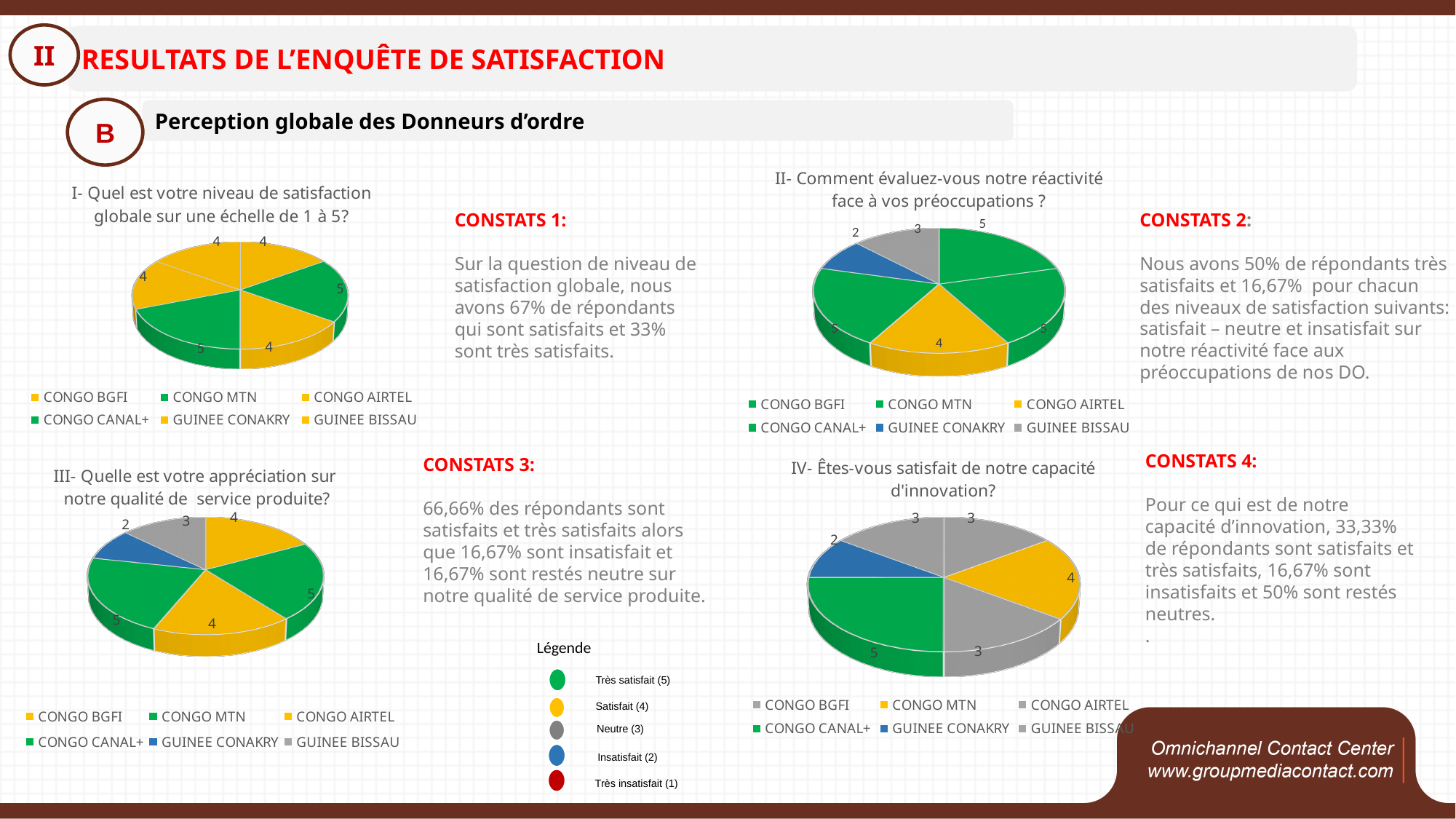
According to the 'Légende' box, which rating value does the green colour represent? Très satisfait (5) In the chart for question IV (capacité d'innovation), which is larger: the rating for CONGO MTN or the rating for GUINEE CONAKRY? CONGO MTN How many entries does the legend of the chart for question II (réactivité) list? 6 In the chart for question II (réactivité), which company has the lowest rating? GUINEE CONAKRY What kind of chart is used for question I, 'Quel est votre niveau de satisfaction globale sur une échelle de 1 à 5?' Pie chart In the chart for question IV (capacité d'innovation), what rating is shown for CONGO CANAL+? 5 In the chart for question II (réactivité), what is the difference between the rating for CONGO AIRTEL and the rating for GUINEE CONAKRY? 2 How many slices does the pie chart for question I (satisfaction globale) have? 6 In the chart for question II (réactivité face à vos préoccupations), what rating is shown for GUINEE CONAKRY? 2 In the chart for question IV (capacité d'innovation), which company has the highest rating? CONGO CANAL+ In the chart for question III (qualité de service produite), what rating is shown for GUINEE BISSAU? 3 In the chart for question II (réactivité face à vos préoccupations), what rating is shown for CONGO AIRTEL? 4